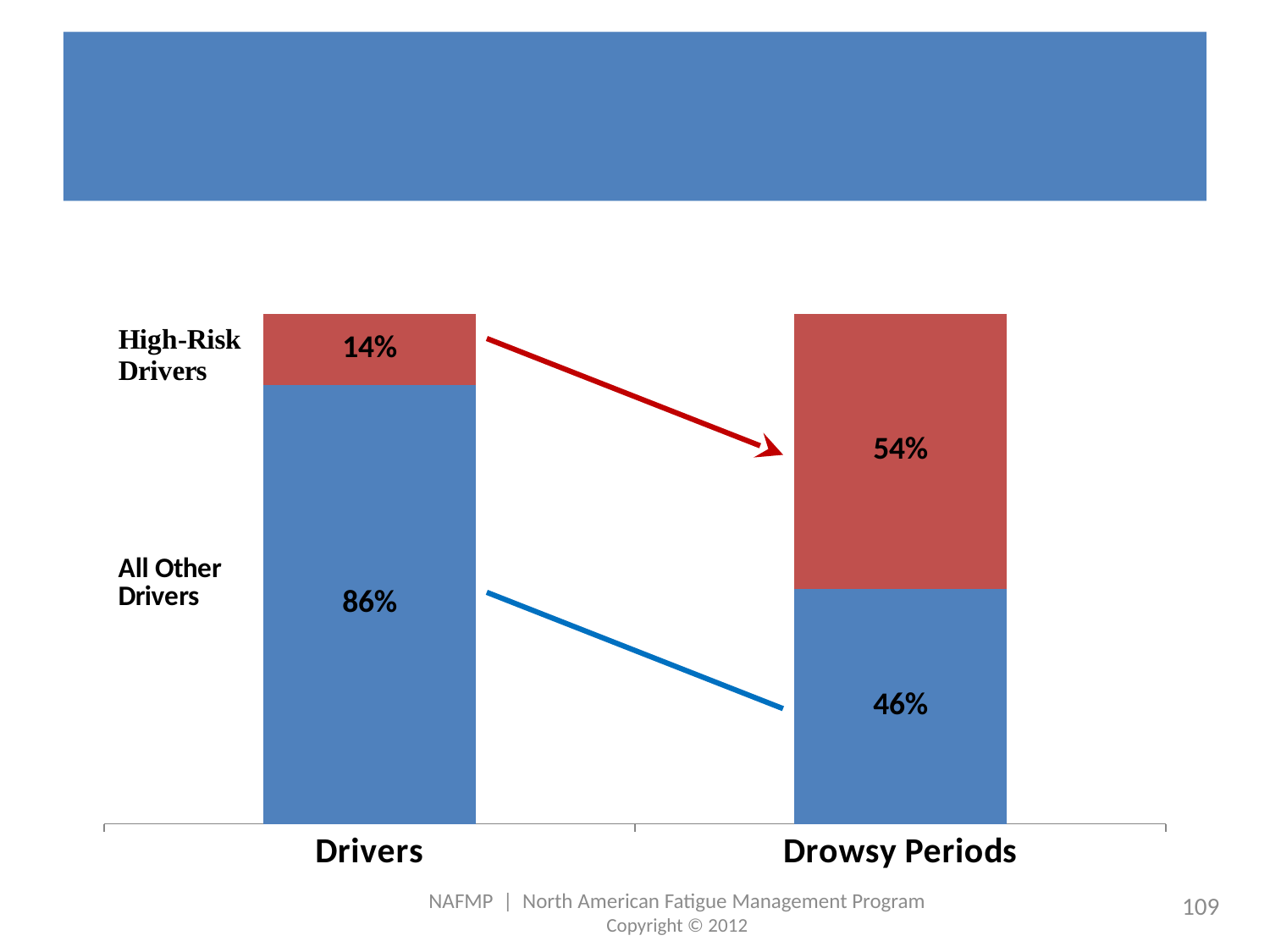
How many categories are shown on the x axis? 2 In the Drowsy Periods bar, which segment is larger, High-Risk Drivers or All Other Drivers? High-Risk Drivers What percentage of Drivers are High-Risk Drivers? 14% What percentage of Drowsy Periods are attributed to All Other Drivers? 46% Which category has the larger High-Risk Drivers segment, Drivers or Drowsy Periods? Drowsy Periods What percentage of Drivers are All Other Drivers? 86% What colour represents High-Risk Drivers in the chart? Red How many series are shown in the stacked bars? 2 What is the difference between the High-Risk Drivers share of Drowsy Periods and their share of Drivers? 40 percentage points What is the total of the Drivers stacked bar? 100% What percentage of Drowsy Periods are attributed to High-Risk Drivers? 54% What kind of chart is shown on the slide? Stacked bar chart